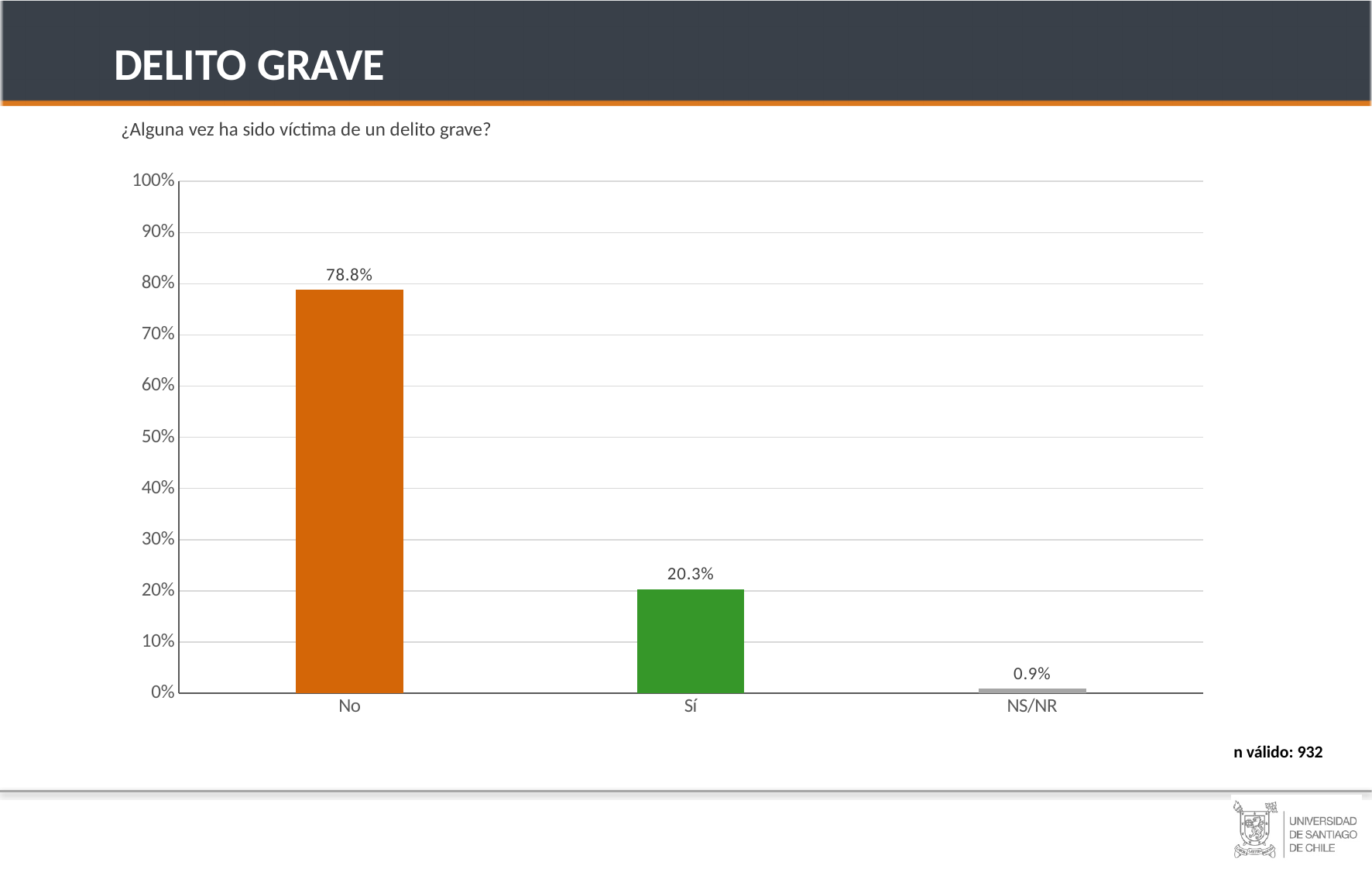
What is the difference between the values for "No" and "Sí"? 58.5% Which category has the highest value? No Which is larger, the value for "Sí" or the value for "NS/NR"? Sí What is the value for "NS/NR"? 0.9% Is the value for "No" greater or less than 70%? greater What question is the chart answering, as written above it? ¿Alguna vez ha sido víctima de un delito grave? What is the value for "Sí"? 20.3% Which category has the lowest value? NS/NR What kind of chart is shown on the slide? bar chart What colour is the bar for "Sí"? green How many categories are shown on the x axis? 3 What is the value for "No"? 78.8%